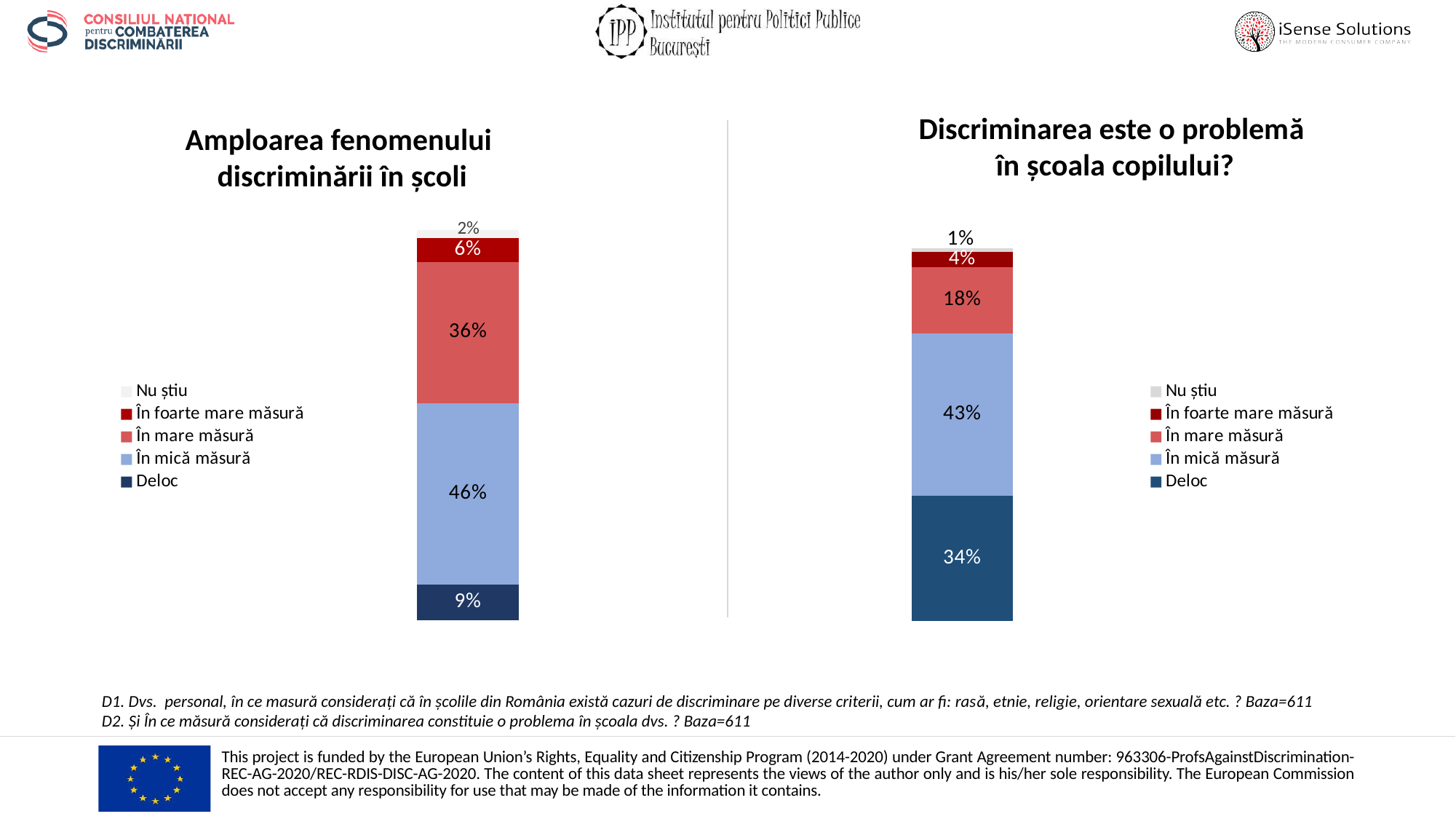
What kind of chart is the chart titled "Discriminarea este o problemă în școala copilului?"? Stacked bar chart In the chart titled "Discriminarea este o problemă în școala copilului?", what is the total of all the segments in the stacked bar? 100% In the chart titled "Amploarea fenomenului discriminării în școli", which response category has the largest share? În mică măsură In the chart titled "Discriminarea este o problemă în școala copilului?", which response category has the smallest share? Nu știu Which chart shows a larger "Deloc" share: the left chart ("Amploarea fenomenului discriminării în școli") or the right chart ("Discriminarea este o problemă în școala copilului?")? The right chart In the chart titled "Amploarea fenomenului discriminării în școli", what percentage is shown for "În mică măsură"? 46% In the chart titled "Discriminarea este o problemă în școala copilului?", what percentage is shown for "Deloc"? 34% In the chart titled "Discriminarea este o problemă în școala copilului?", what percentage is shown for "În mare măsură"? 18% In the chart titled "Amploarea fenomenului discriminării în școli", what percentage is shown for "Deloc"? 9% In the chart titled "Amploarea fenomenului discriminării în școli", what is the difference between the "În mică măsură" and "În mare măsură" percentages? 10% In the chart titled "Discriminarea este o problemă în școala copilului?", what is the difference between the "În mică măsură" and "Deloc" percentages? 9% How many series does the legend of the chart titled "Amploarea fenomenului discriminării în școli" list? 5